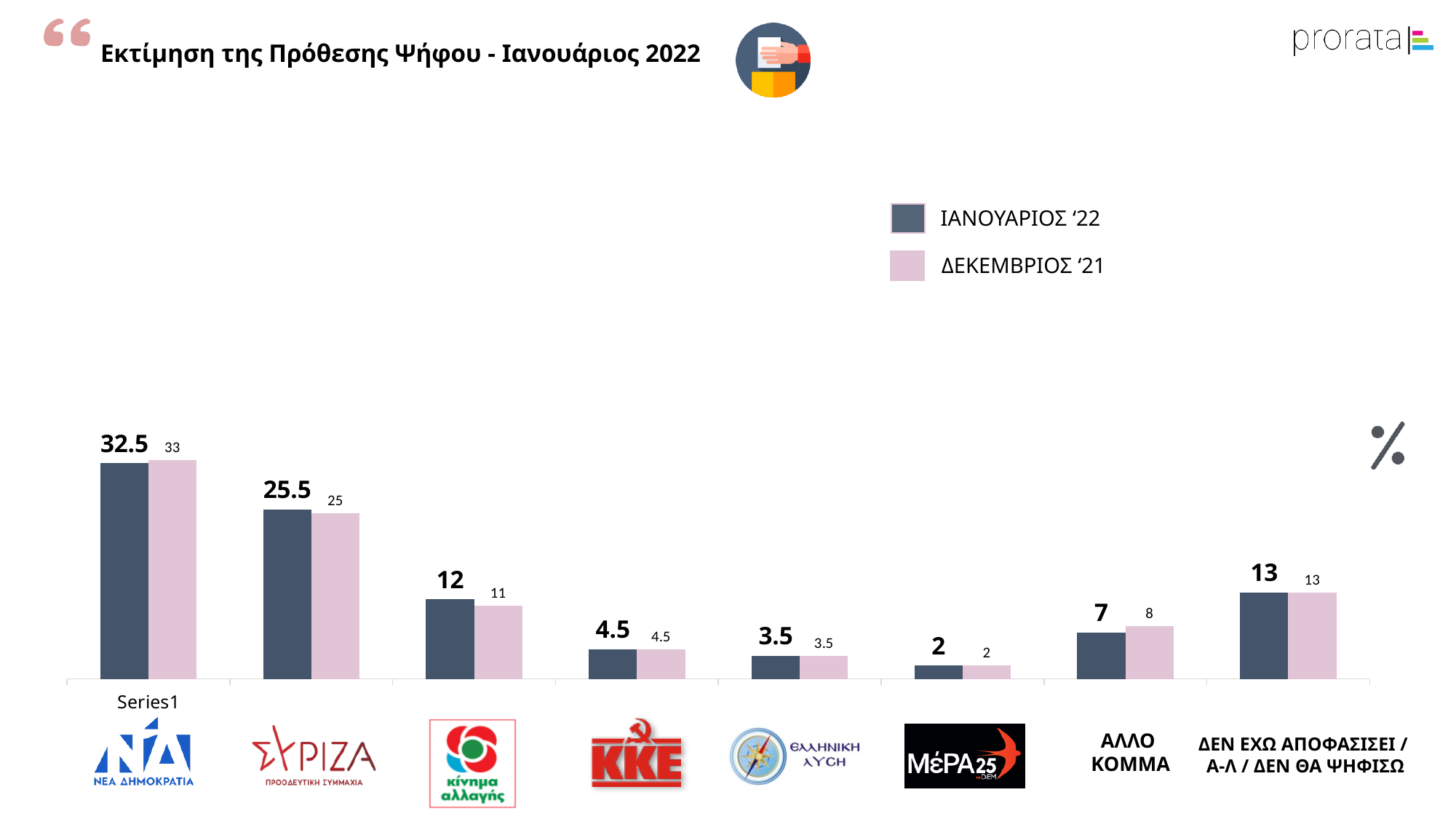
For ΑΛΛΟ ΚΟΜΜΑ, which is larger: the ΙΑΝΟΥΑΡΙΟΣ '22 value or the ΔΕΚΕΜΒΡΙΟΣ '21 value? ΔΕΚΕΜΒΡΙΟΣ '21 Which category has the lowest ΙΑΝΟΥΑΡΙΟΣ '22 value? ΜέΡΑ25 What is the ΙΑΝΟΥΑΡΙΟΣ '22 value for ΝΕΑ ΔΗΜΟΚΡΑΤΙΑ? 32.5 How many categories are shown on the x axis of the chart? 8 What is the ΔΕΚΕΜΒΡΙΟΣ '21 value for ΣΥΡΙΖΑ? 25 What is the title of the chart? Εκτίμηση της Πρόθεσης Ψήφου - Ιανουάριος 2022 What is the ΔΕΚΕΜΒΡΙΟΣ '21 value for ΑΛΛΟ ΚΟΜΜΑ? 8 What is the difference between the ΙΑΝΟΥΑΡΙΟΣ '22 values for ΝΕΑ ΔΗΜΟΚΡΑΤΙΑ and ΣΥΡΙΖΑ? 7 Which party has the highest ΙΑΝΟΥΑΡΙΟΣ '22 value? ΝΕΑ ΔΗΜΟΚΡΑΤΙΑ How many series does the legend list? 2 What is the ΙΑΝΟΥΑΡΙΟΣ '22 value for Κίνημα Αλλαγής? 12 What kind of chart is shown on the slide? Bar chart